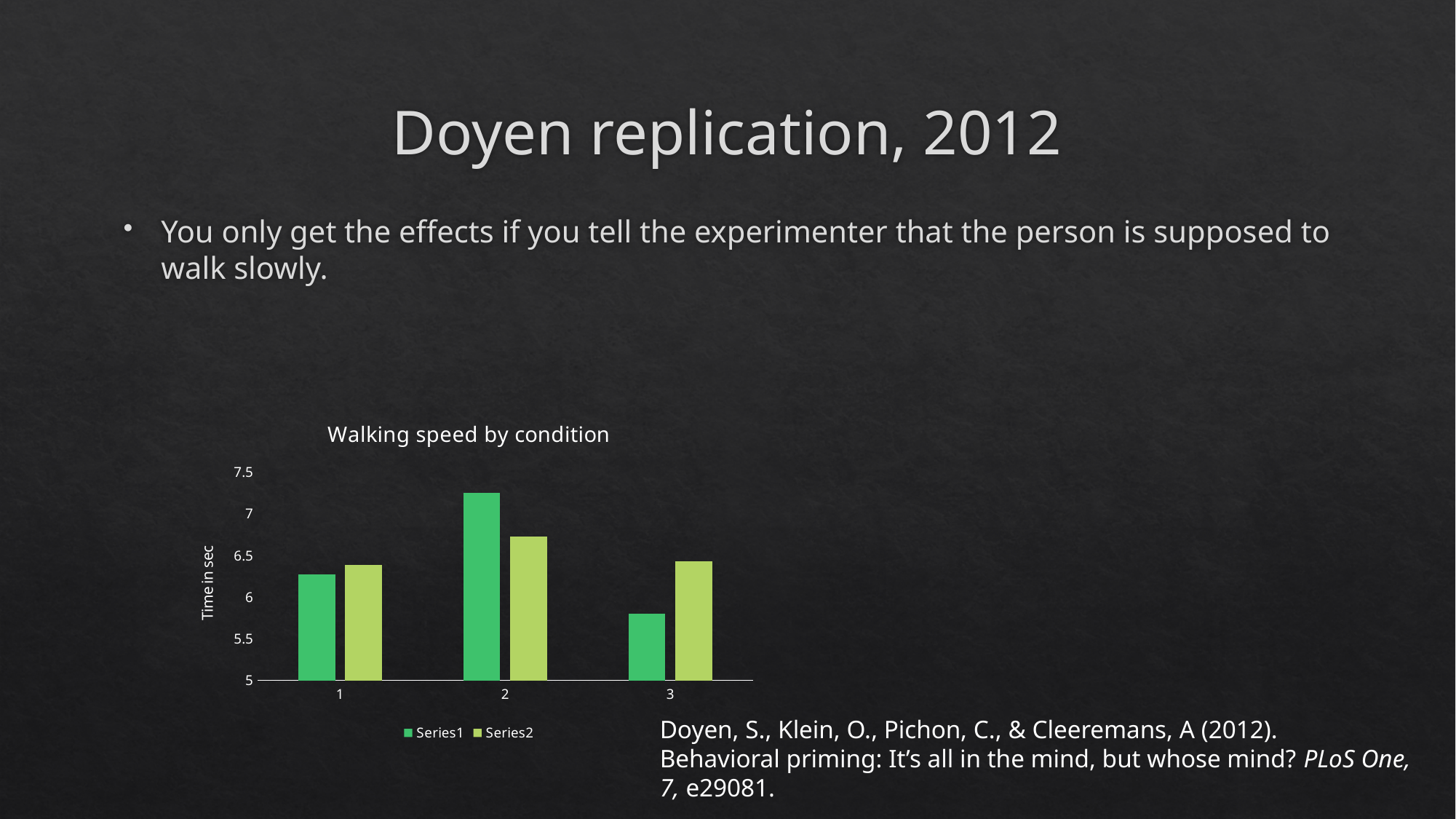
In the "Walking speed by condition" chart, for category 2, which series has the larger value, Series1 or Series2? Series1 In the "Walking speed by condition" chart, which category has the highest Series2 value? 2 How many series does the legend of the "Walking speed by condition" chart list? 2 What are the two legend entries in the "Walking speed by condition" chart? Series1 and Series2 In the "Walking speed by condition" chart, which category has the highest Series1 value? 2 What is the y-axis label of the "Walking speed by condition" chart? Time in sec In the "Walking speed by condition" chart, is the Series1 value for category 3 greater or less than 6? less In the "Walking speed by condition" chart, for category 3, which series has the larger value, Series1 or Series2? Series2 In the "Walking speed by condition" chart, which category has the lowest Series1 value? 3 In the "Walking speed by condition" chart, is the Series1 value for category 2 greater or less than 7? greater How many categories are shown on the x axis of the "Walking speed by condition" chart? 3 What type of chart is shown under the title "Walking speed by condition"? bar chart